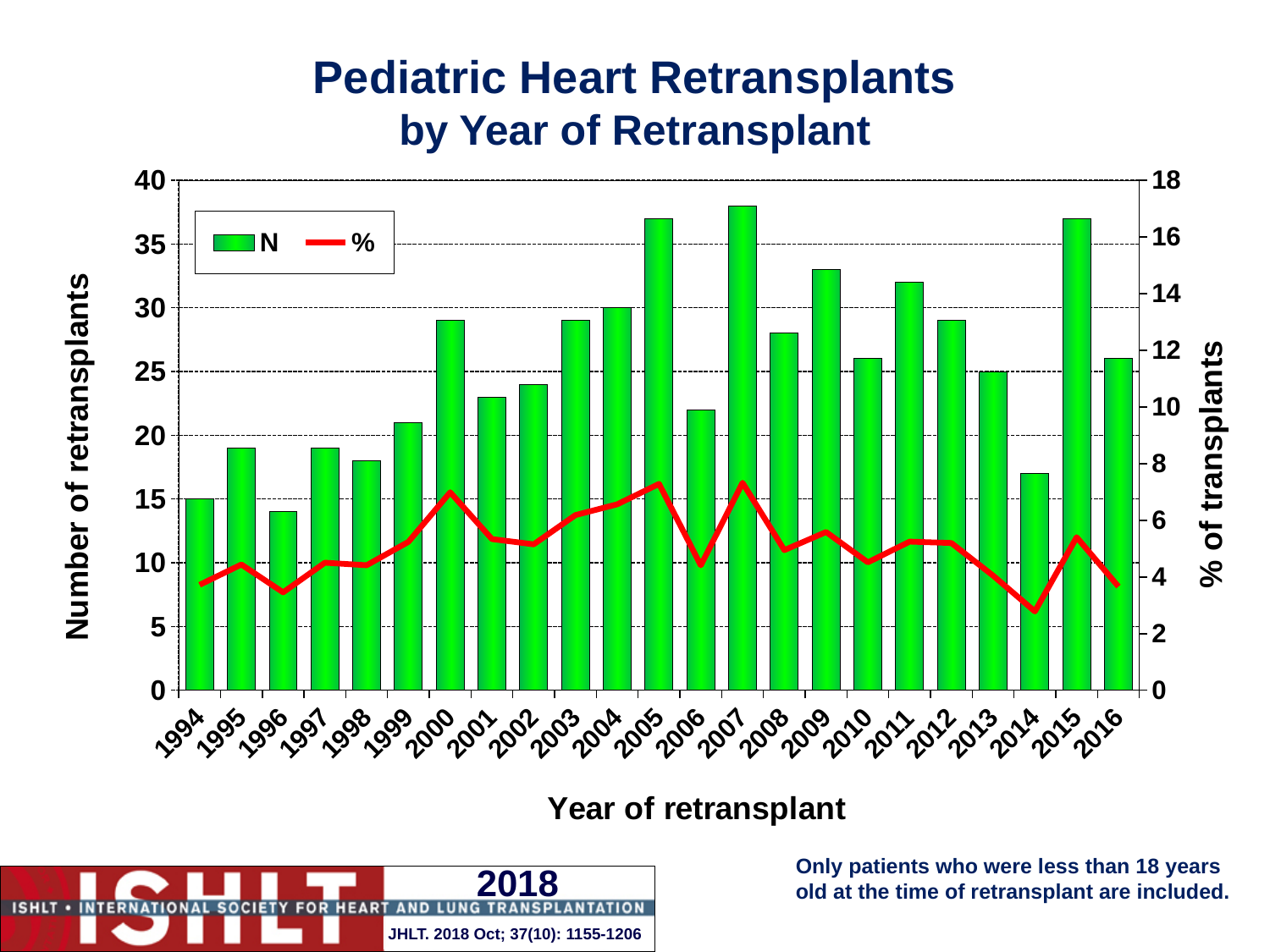
What is the number of retransplants for 2013? 25 Which year has more retransplants, 2000 or 1994? 2000 How many series does the legend list? 2 Is the % of transplants value for 2014 greater or less than 4? less Is the % of transplants value for 2005 greater or less than 6? greater What is the number of retransplants for 2004? 30 Does the % of transplants line rise or fall from 2012 to 2014? fall What is the number of retransplants for 1994? 15 Is the number of retransplants for 1996 greater or less than 15? less How many years are shown on the x axis? 23